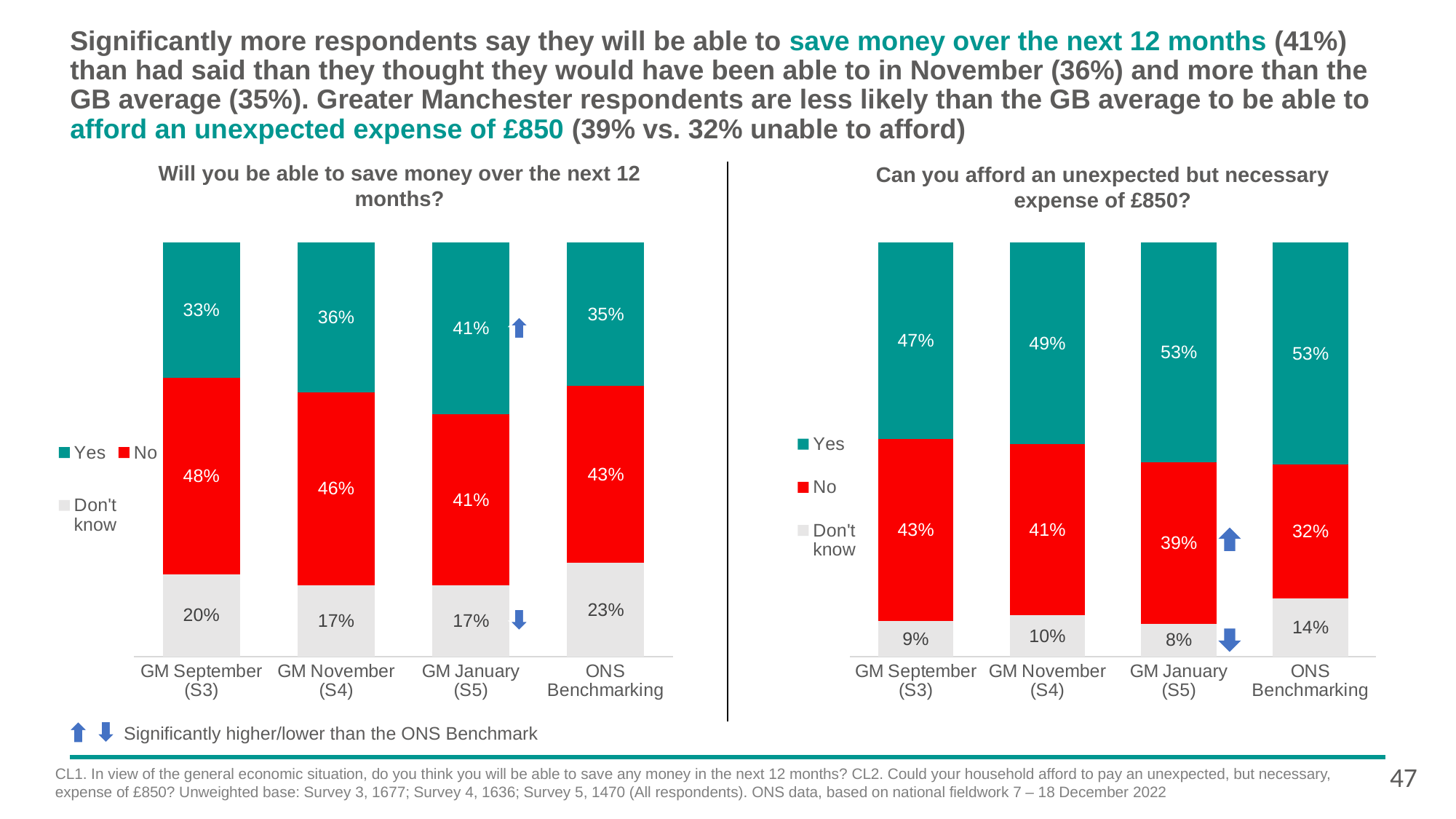
In the chart 'Can you afford an unexpected but necessary expense of £850?', what is the difference between the 'No' values for GM January (S5) and ONS Benchmarking? 7% In the chart 'Will you be able to save money over the next 12 months?', what is the 'Yes' value for GM January (S5)? 41% In the chart 'Will you be able to save money over the next 12 months?', which category has the highest 'No' value? GM September (S3) In the chart 'Will you be able to save money over the next 12 months?', what is the 'Don't know' value for ONS Benchmarking? 23% In the chart 'Will you be able to save money over the next 12 months?', what is the difference between the 'No' values for GM September (S3) and GM January (S5)? 7% In the chart 'Can you afford an unexpected but necessary expense of £850?', do the 'Yes' values rise or fall from GM September (S3) to GM January (S5)? rise In the chart 'Will you be able to save money over the next 12 months?', how many series does the legend list? 3 What kind of chart is used on the left side of the slide? Stacked bar chart In the chart 'Can you afford an unexpected but necessary expense of £850?', is the 'Yes' value larger for GM September (S3) or GM November (S4)? GM November (S4) In the chart 'Can you afford an unexpected but necessary expense of £850?', how many categories are shown on the x axis? 4 In the chart 'Can you afford an unexpected but necessary expense of £850?', what is the 'No' value for ONS Benchmarking? 32% In the chart 'Can you afford an unexpected but necessary expense of £850?', which category has the lowest 'Don't know' value? GM January (S5)